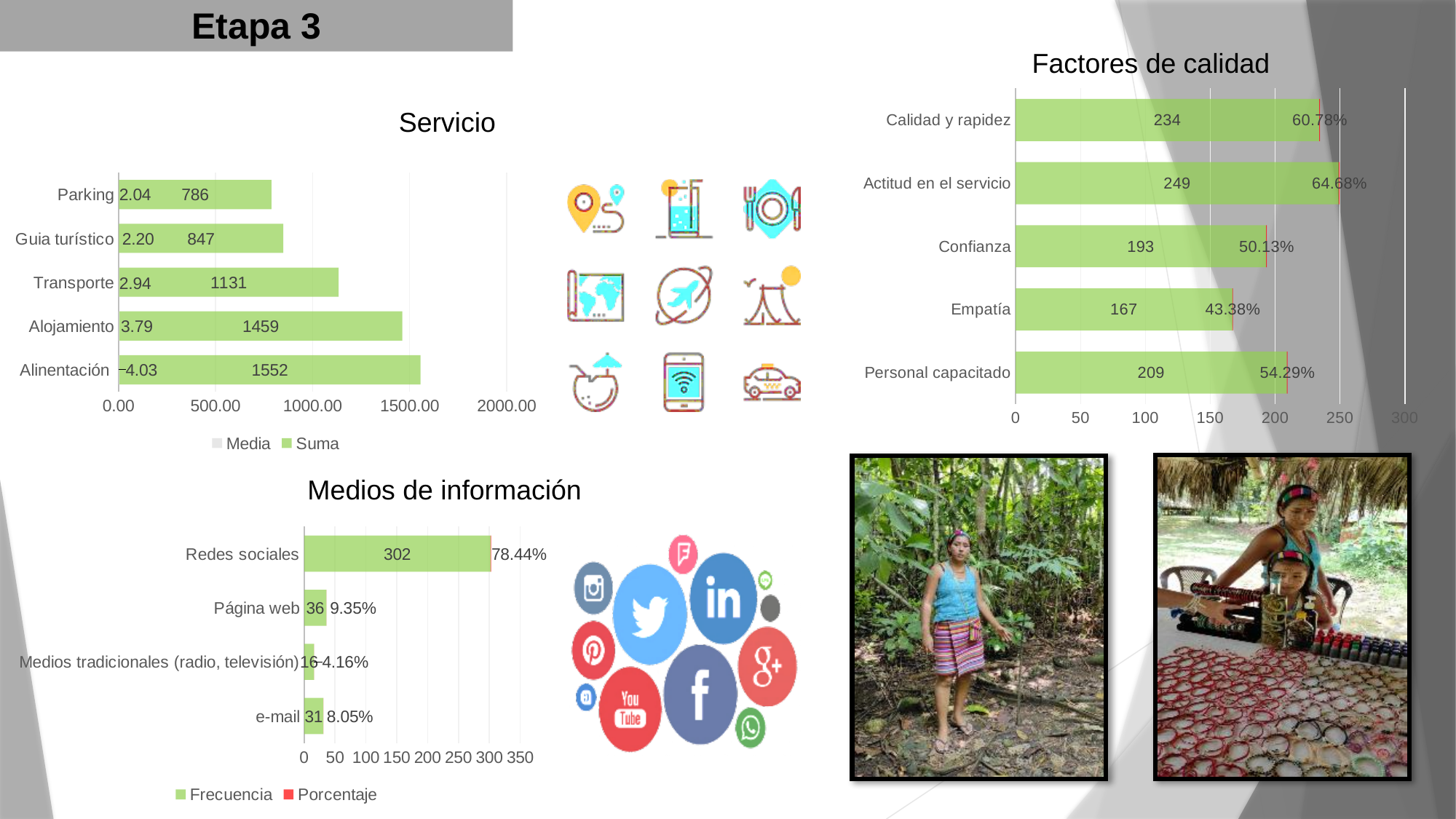
In the 'Factores de calidad' chart, how many categories are shown? 5 In the 'Servicio' chart, what is the difference between the Suma values for Alojamiento and Parking? 673 In the 'Medios de información' chart, which is larger, the Frecuencia for Página web or for e-mail? Página web In the 'Medios de información' chart, what is the Frecuencia value for Redes sociales? 302 In the 'Factores de calidad' chart, which category has the lowest value? Empatía What kind of chart is the 'Medios de información' chart? Bar chart In the 'Servicio' chart, how many series does the legend list? 2 In the 'Factores de calidad' chart, what percentage is shown for Actitud en el servicio? 64.68% In the 'Servicio' chart, which category has the highest Suma value? Alinentación In the 'Servicio' chart, what is the Media value for Alojamiento? 3.79 In the 'Servicio' chart, what is the Suma value for Transporte? 1131 In the 'Factores de calidad' chart, what is the value for Confianza? 193